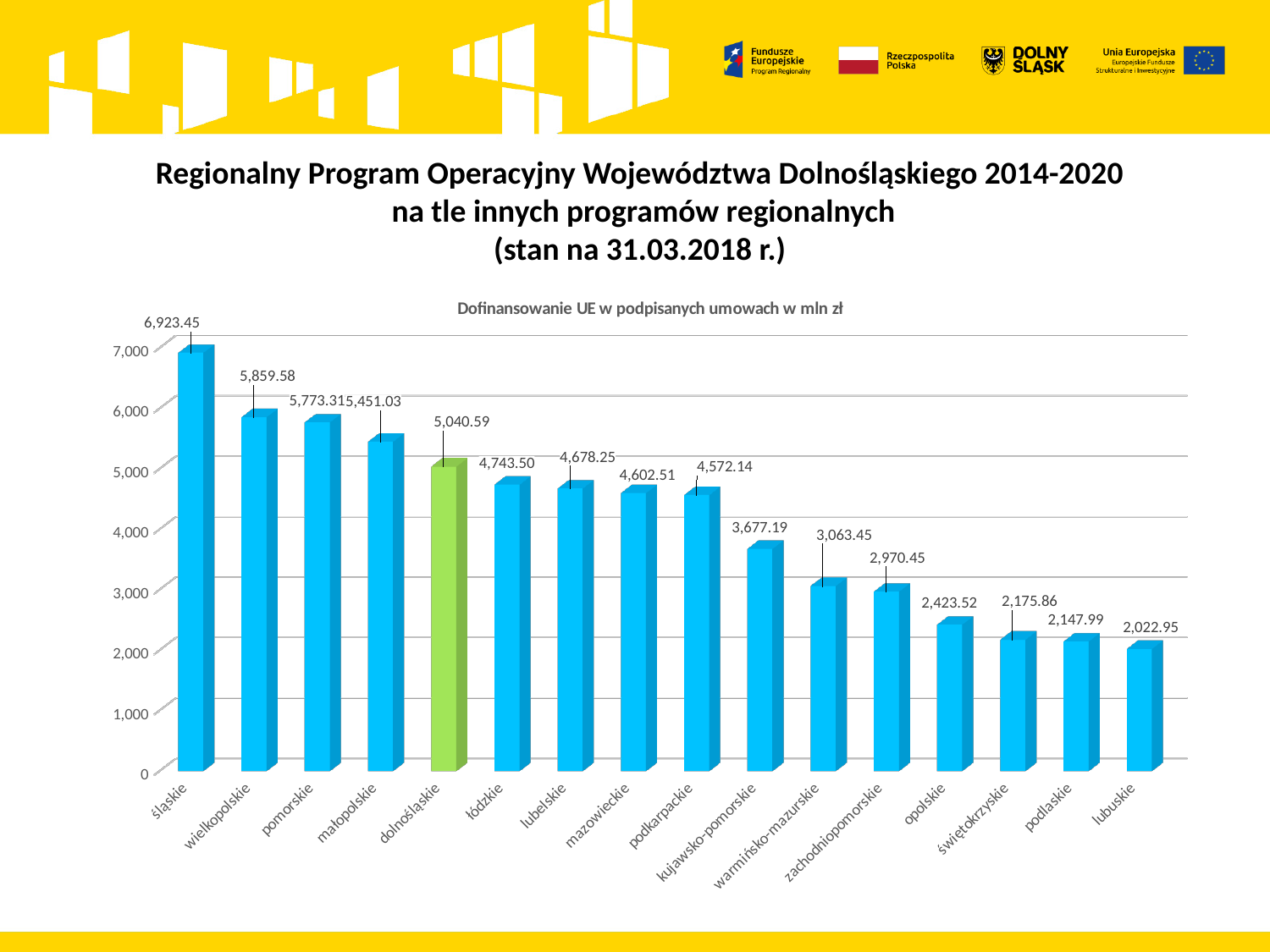
What is the difference between the values for śląskie and dolnośląskie? 1,882.86 Is the value for kujawsko-pomorskie greater or less than 4,000? less What is the difference between the values for opolskie and świętokrzyskie? 247.66 How many regions are shown on the chart? 16 What is the value for lubuskie? 2,022.95 Which region has the lowest value? lubuskie Which is larger, the value for łódzkie or the value for lubelskie? łódzkie Which region has the highest value? śląskie What is the value for śląskie? 6,923.45 What is the value for dolnośląskie? 5,040.59 Do the values rise or fall from left to right along the x axis? fall What kind of chart is shown on the slide? bar chart